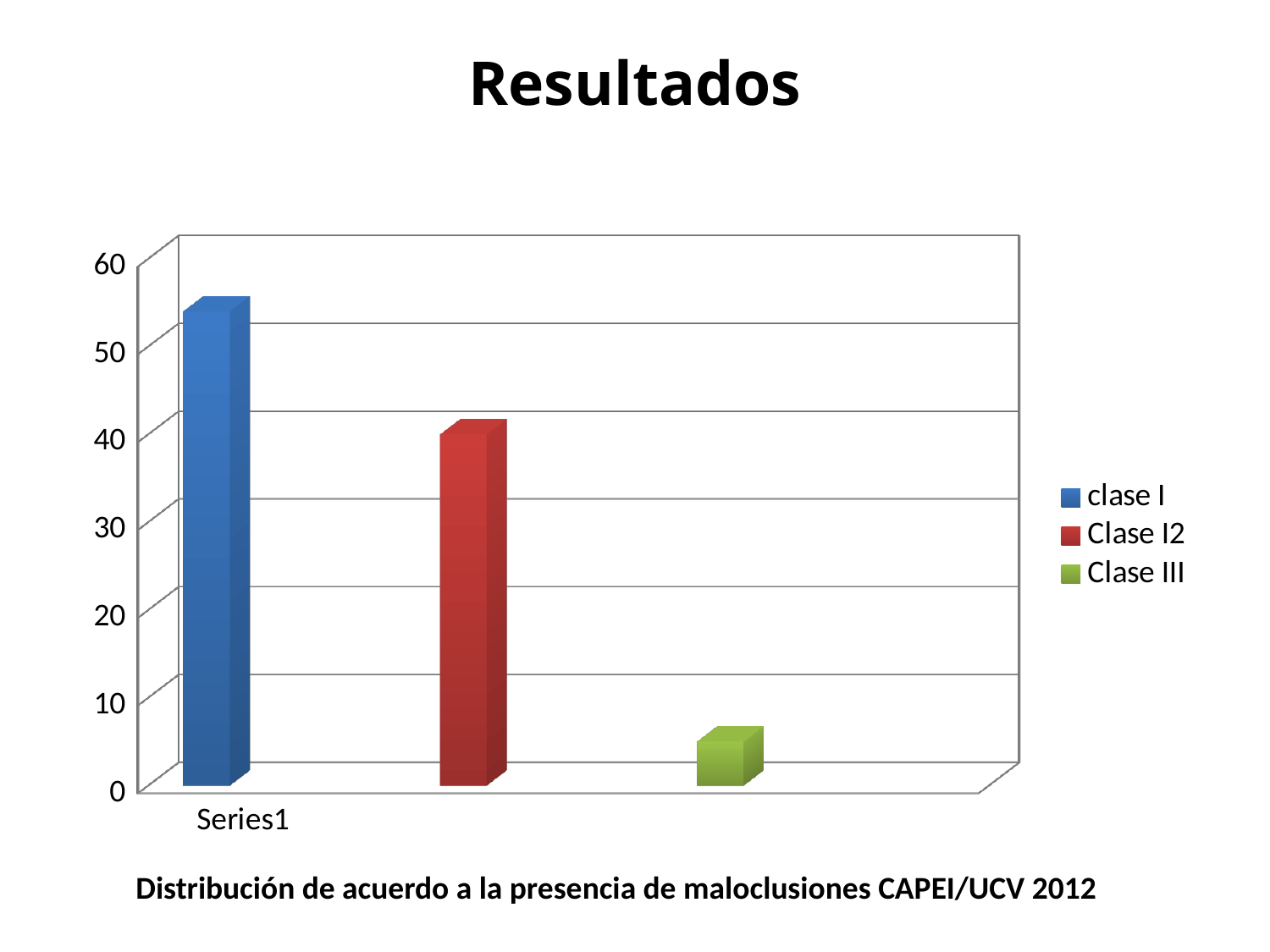
What colour is the bar for Clase III? green What is the caption printed below the chart? Distribución de acuerdo a la presencia de maloclusiones CAPEI/UCV 2012 Is the value for clase I greater or less than 50? greater What kind of chart is shown on the slide? bar chart Which series has the highest value? clase I Is the value for Clase I2 greater or less than 50? less Which is larger, the value for clase I or the value for Clase I2? clase I How many series does the legend list? 3 Which series has the lowest value? Clase III Which is larger, the value for Clase I2 or the value for Clase III? Clase I2 Is the value for Clase III greater or less than 10? less